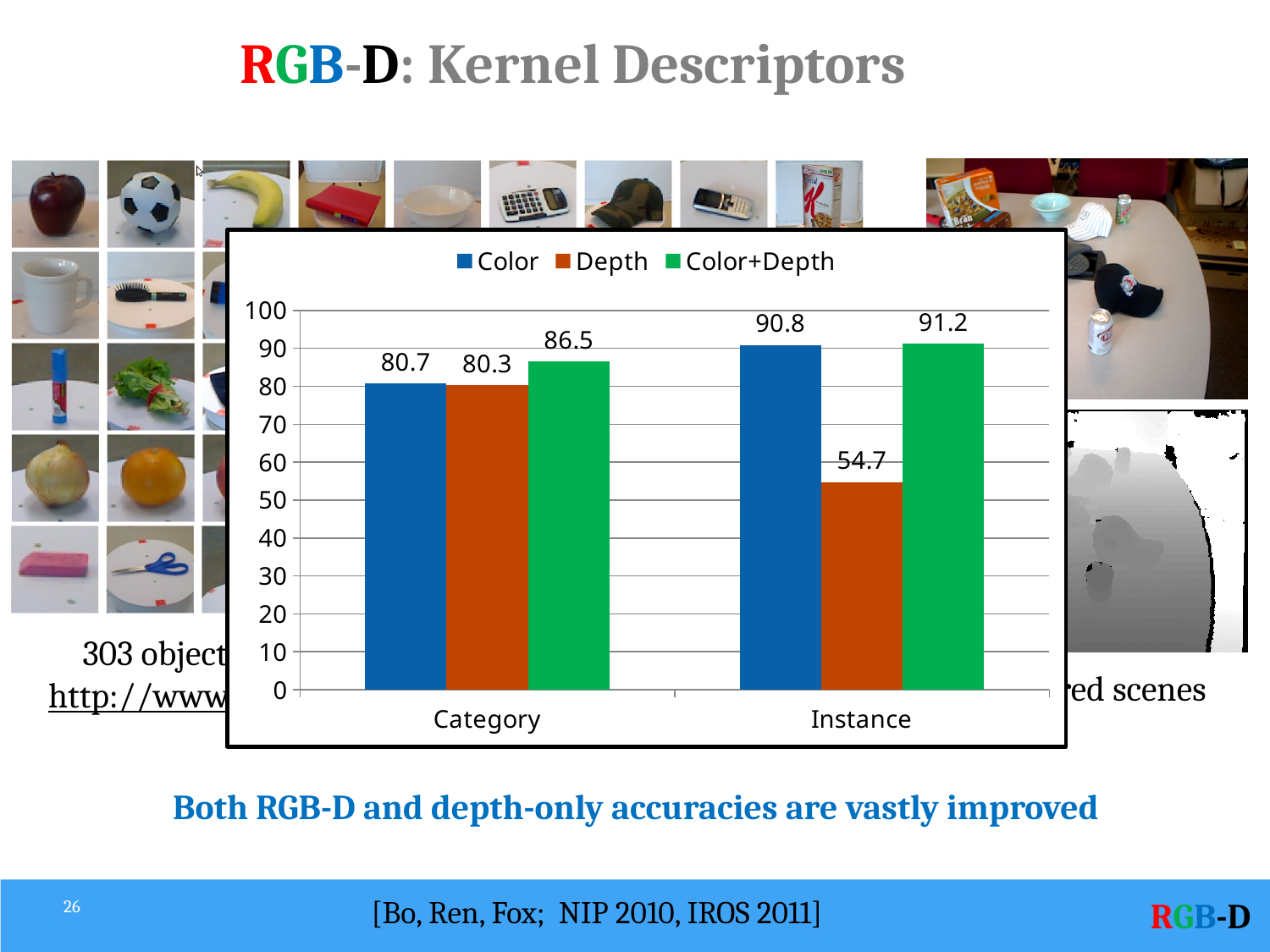
How many categories are shown on the x axis? 2 How many series does the legend list? 3 What is the Color+Depth value for Instance? 91.2 What is the difference between the Color+Depth and Color values for Category? 5.8 What is the Depth value for Category? 80.3 Is the Depth value for Instance greater or less than 60? less What kind of chart is shown? bar chart What is the Depth value for Instance? 54.7 What is the difference between the Color and Depth values for Instance? 36.1 Which series has the lowest value for Instance? Depth What is the Color value for Category? 80.7 Which series has the highest value for Category? Color+Depth